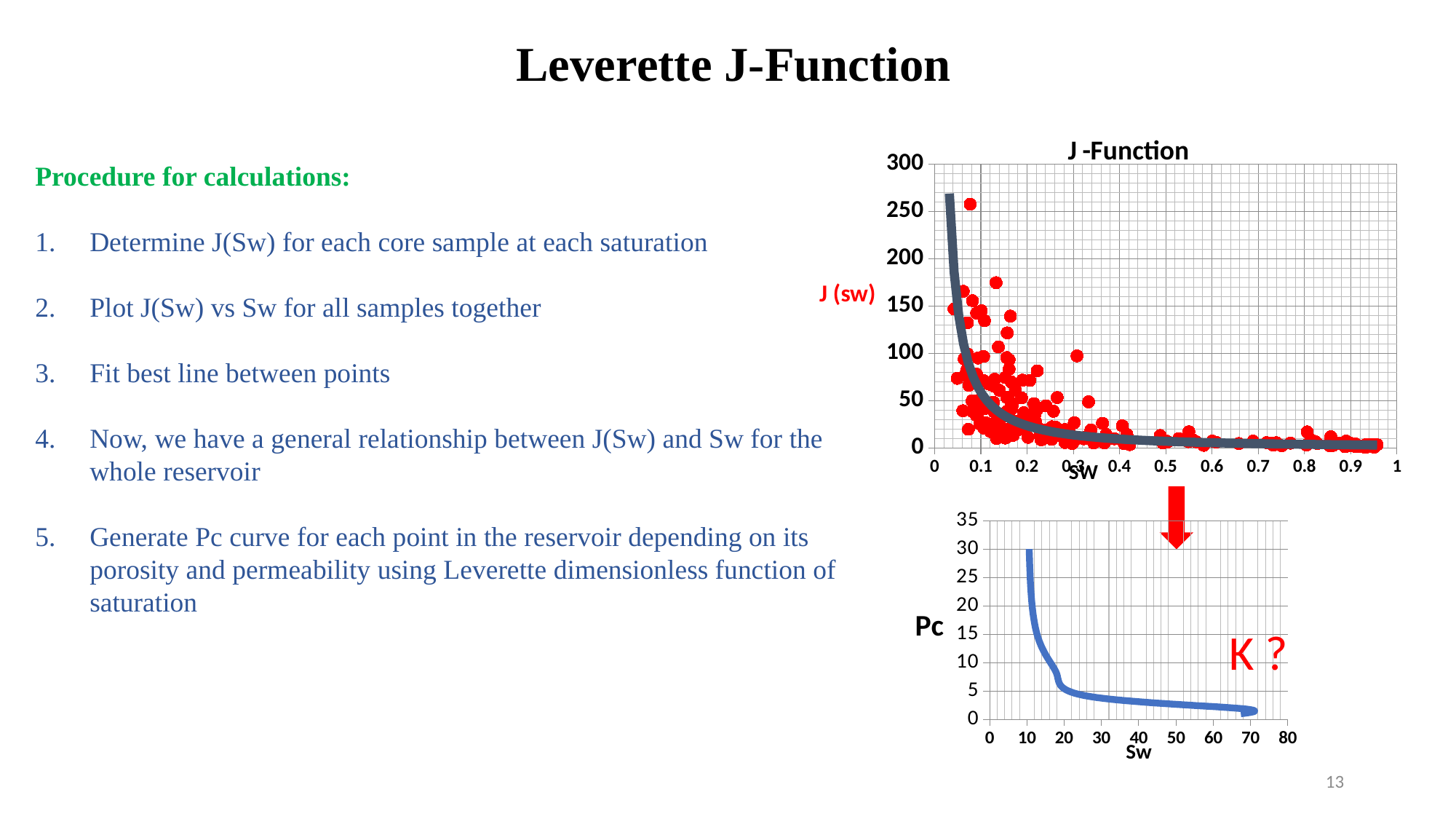
In the lower chart of Pc versus Sw, what is the highest value shown on the y axis? 35 In the upper chart titled "J -Function", what kind of chart is it? scatter chart In the lower chart of Pc versus Sw, is the Pc value at Sw = 40 greater or less than 10? less In the lower chart of Pc versus Sw, does Pc rise or fall as Sw increases along the x axis? fall In the upper chart titled "J -Function", what is the highest value shown on the y axis? 300 In the upper chart titled "J -Function", what is the label of the y axis? J (sw) In the lower chart of Pc versus Sw, what kind of chart is it? line chart In the upper chart titled "J -Function", is the fitted curve value at Sw = 0.5 greater or less than 50? less What is the title of the upper chart on the slide? J -Function In the upper chart titled "J -Function", do the J(sw) values generally rise or fall as Sw increases along the x axis? fall